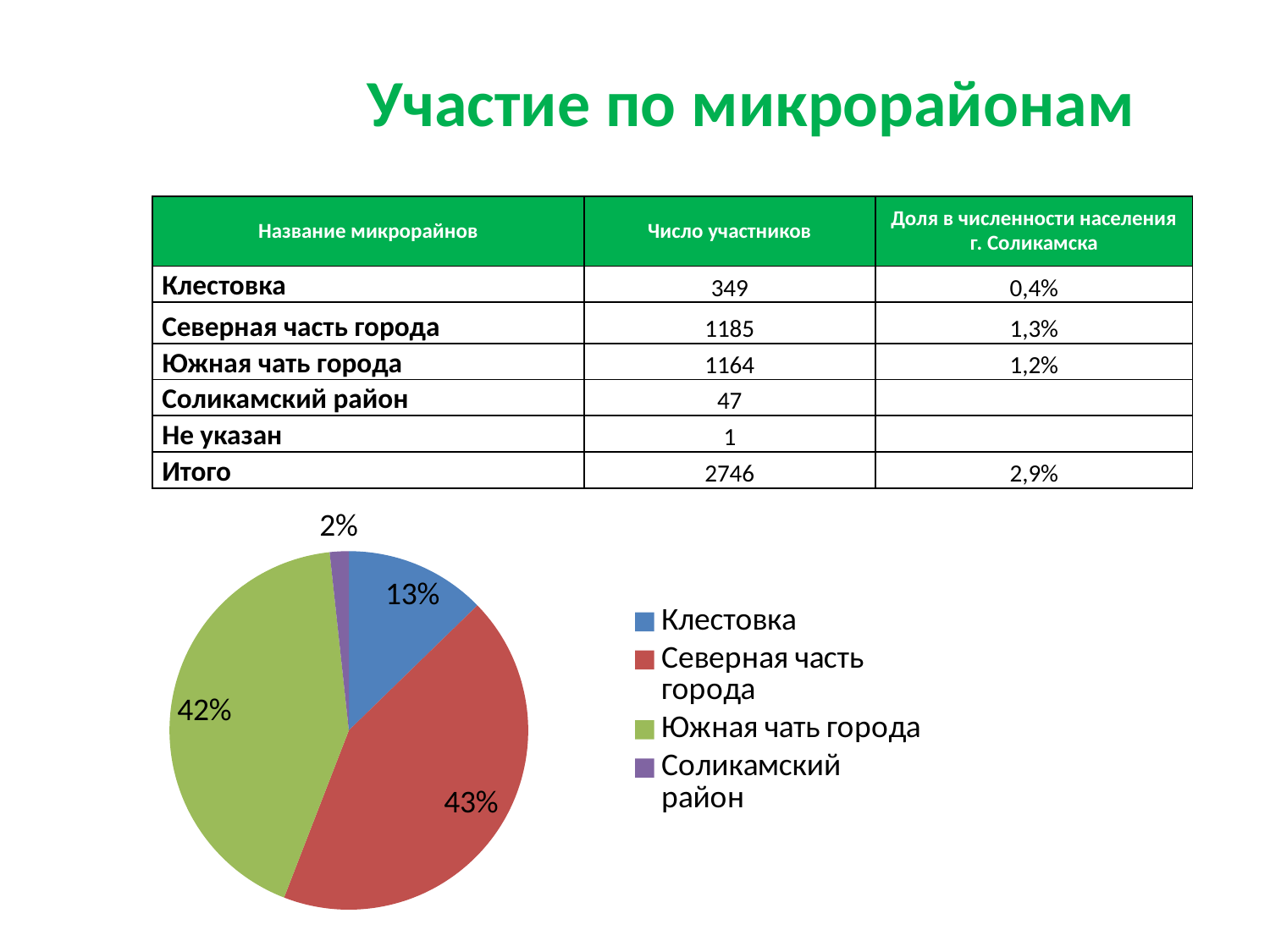
What kind of chart is shown on the slide? pie chart What colour is the Клестовка slice in the pie chart? blue What colour is the Южная чать города slice in the pie chart? green What share of the pie chart does Северная часть города have? 43% What is the difference in percentage points between the Клестовка slice and the Соликамский район slice? 11 How many entries does the pie chart legend list? 4 What share of the pie chart does Соликамский район have? 2% Which slice is larger in the pie chart: Клестовка or Соликамский район? Клестовка What share of the pie chart does Южная чать города have? 42% Which category has the smallest slice in the pie chart? Соликамский район How many slices does the pie chart have? 4